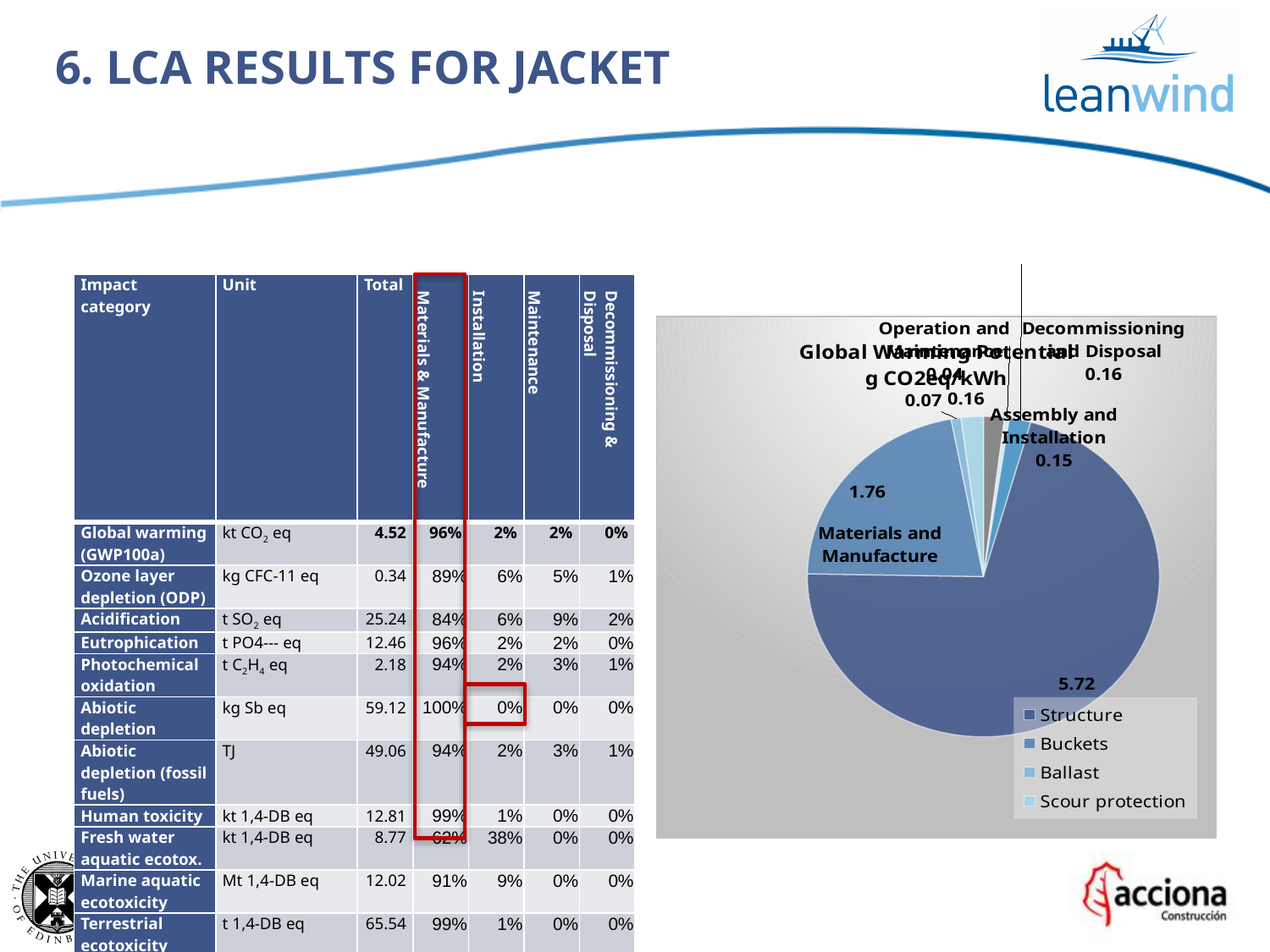
What kind of chart is shown on the right of the slide? pie chart What is the first entry in the legend of the pie chart? Structure Which slice of the pie chart is the largest? Structure In the pie chart, what is the value shown for Assembly and Installation? 0.15 How many entries does the legend of the pie chart list? 4 What unit is given in the title of the pie chart? g CO2eq/kWh In the pie chart, what is the value shown for Decommissioning and Disposal? 0.16